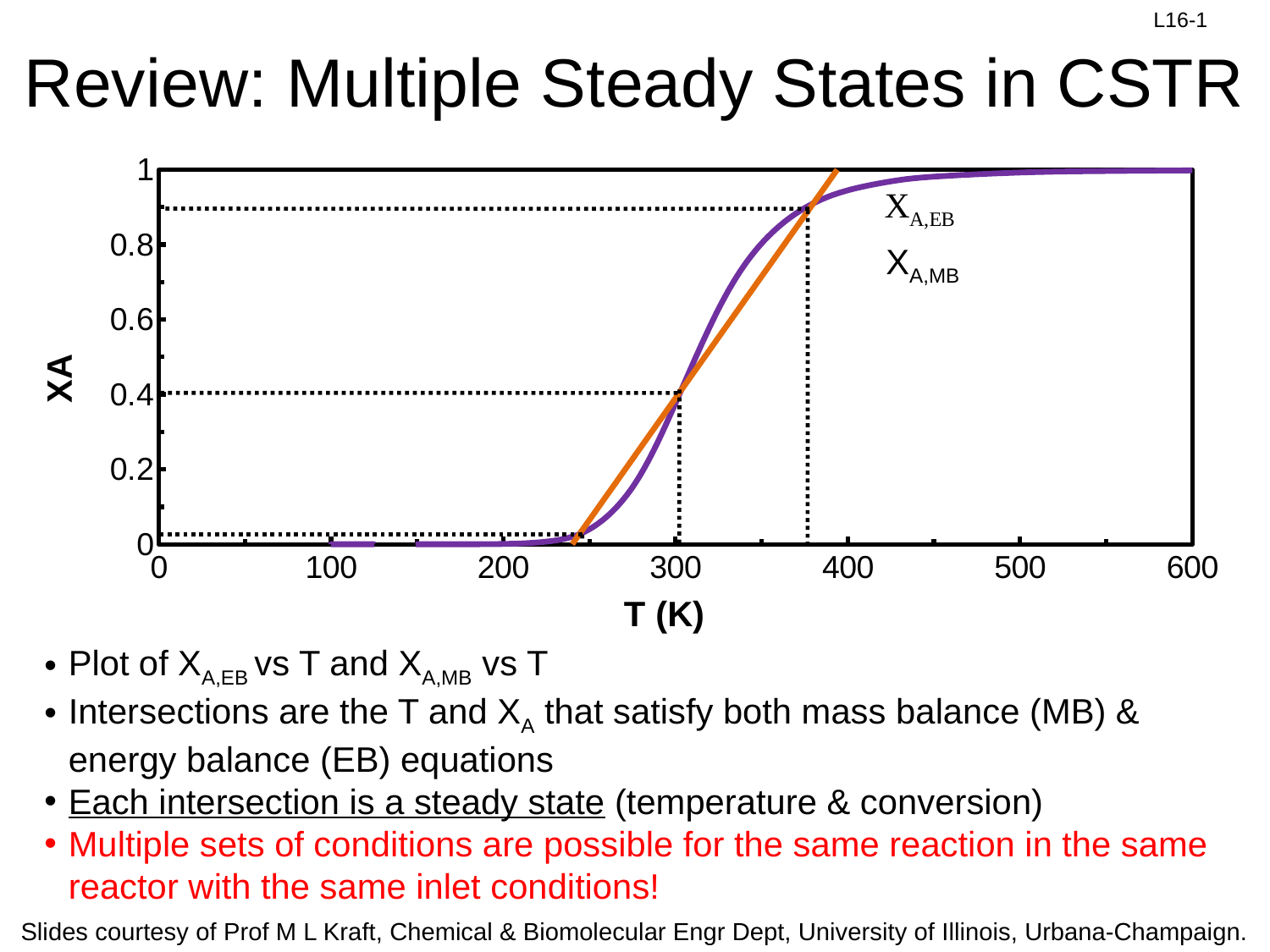
How many series are plotted on the chart? 2 What is the label of the y axis of the chart? XA Is the value of X_A,MB at T = 500 K greater or less than 0.8? greater Is the value of X_A,MB at T = 200 K greater or less than 0.2? less What is the label of the x axis of the chart? T (K) Is the value of X_A,MB at T = 300 K greater or less than 0.6? less What kind of chart is shown on the slide? line chart How many intersections between the X_A,EB line and the X_A,MB curve are marked with dotted lines? 3 Does the X_A,MB curve rise or fall as T increases? rise What is the maximum value shown on the y axis? 1 What is the maximum value shown on the x axis? 600